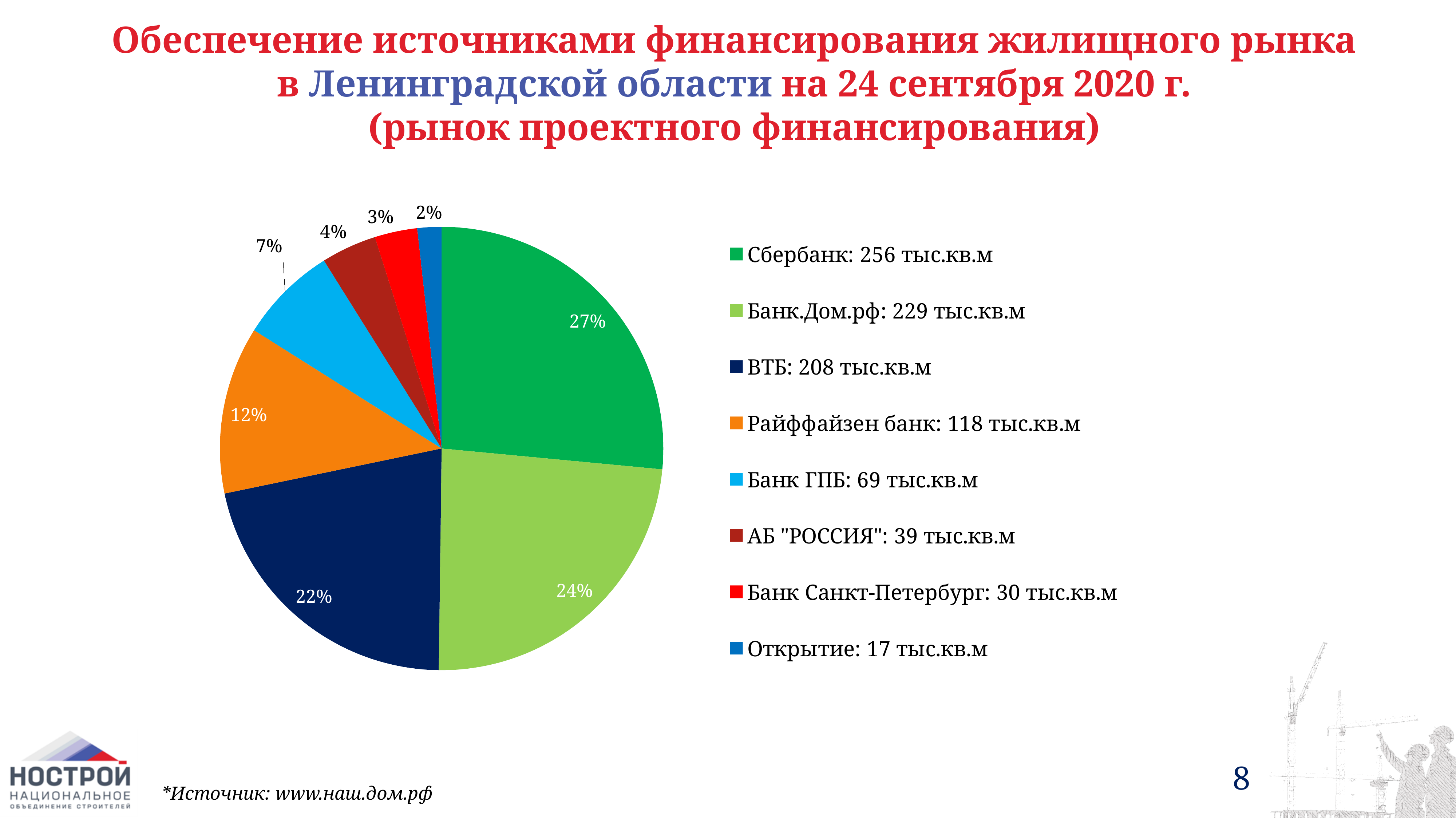
What is the difference between the values for Сбербанк and ВТБ in the legend? 48 тыс.кв.м What share of the pie does ВТБ hold? 22% What share of the pie does Банк ГПБ hold? 7% What value is listed in the legend for Открытие? 17 тыс.кв.м Which bank has the largest slice of the pie? Сбербанк What share of the pie does Райффайзен банк hold? 12% Which is larger, the value for Банк ГПБ or the value for АБ "РОССИЯ"? Банк ГПБ How many slices does the pie chart have? 8 What kind of chart is shown on the slide? pie chart What value is listed in the legend for Банк.Дом.рф? 229 тыс.кв.м Which bank has the smallest slice of the pie? Открытие